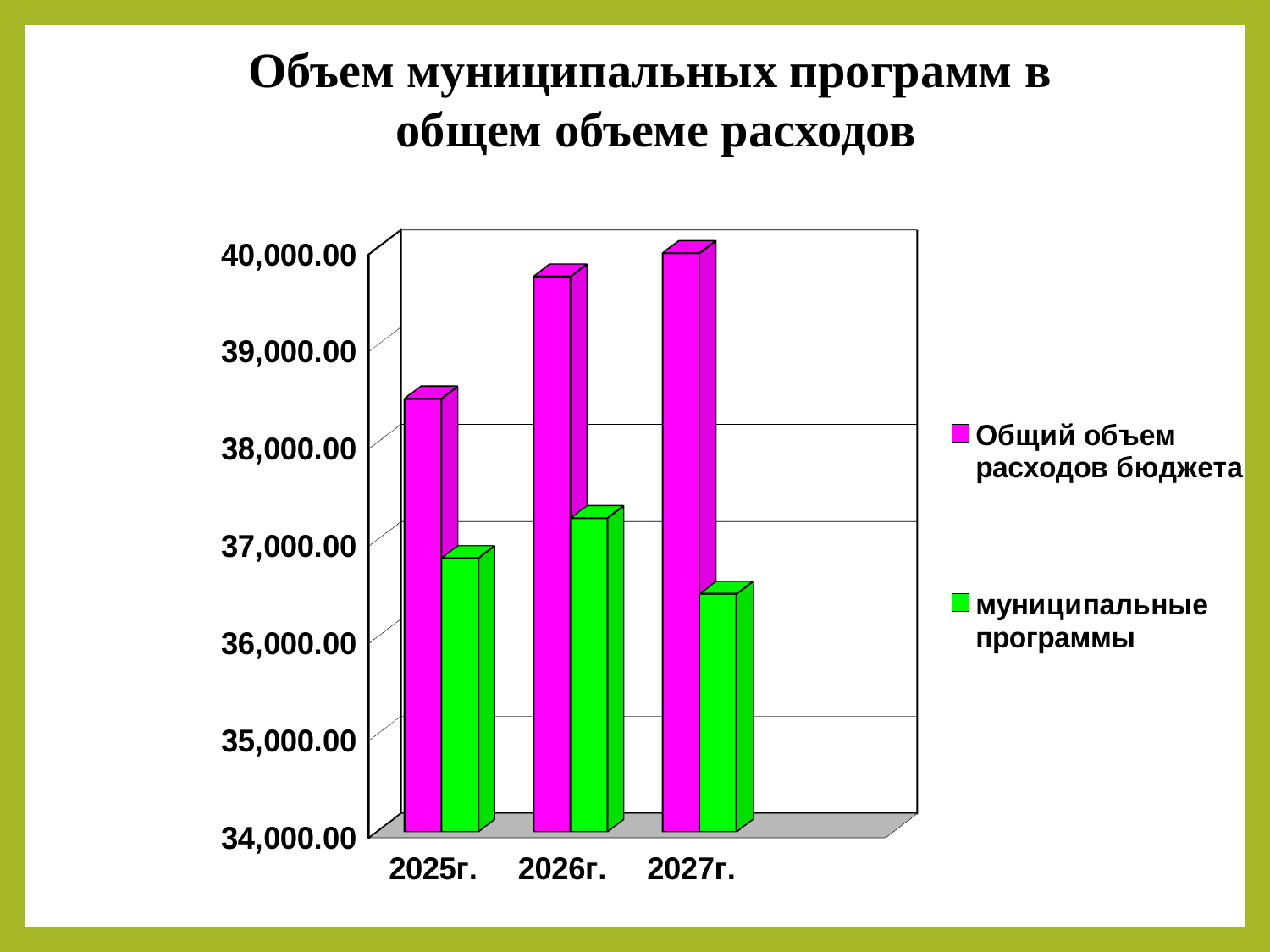
What kind of chart is shown on the slide? bar chart How many years are shown on the x axis? 3 In which year is the value for Общий объем расходов бюджета the lowest? 2025г. Which is larger in 2026г.: Общий объем расходов бюджета or муниципальные программы? Общий объем расходов бюджета In which year is the value for муниципальные программы the highest? 2026г. Is the value for Общий объем расходов бюджета in 2025г. greater or less than 38,000.00? greater How many series does the legend list? 2 Does the value for Общий объем расходов бюджета rise or fall from 2025г. to 2027г.? rise In which year is the value for муниципальные программы the lowest? 2027г. Which series is shown in green? муниципальные программы What is the title of the chart? Объем муниципальных программ в общем объеме расходов Is the value for муниципальные программы in 2027г. greater or less than 37,000.00? less